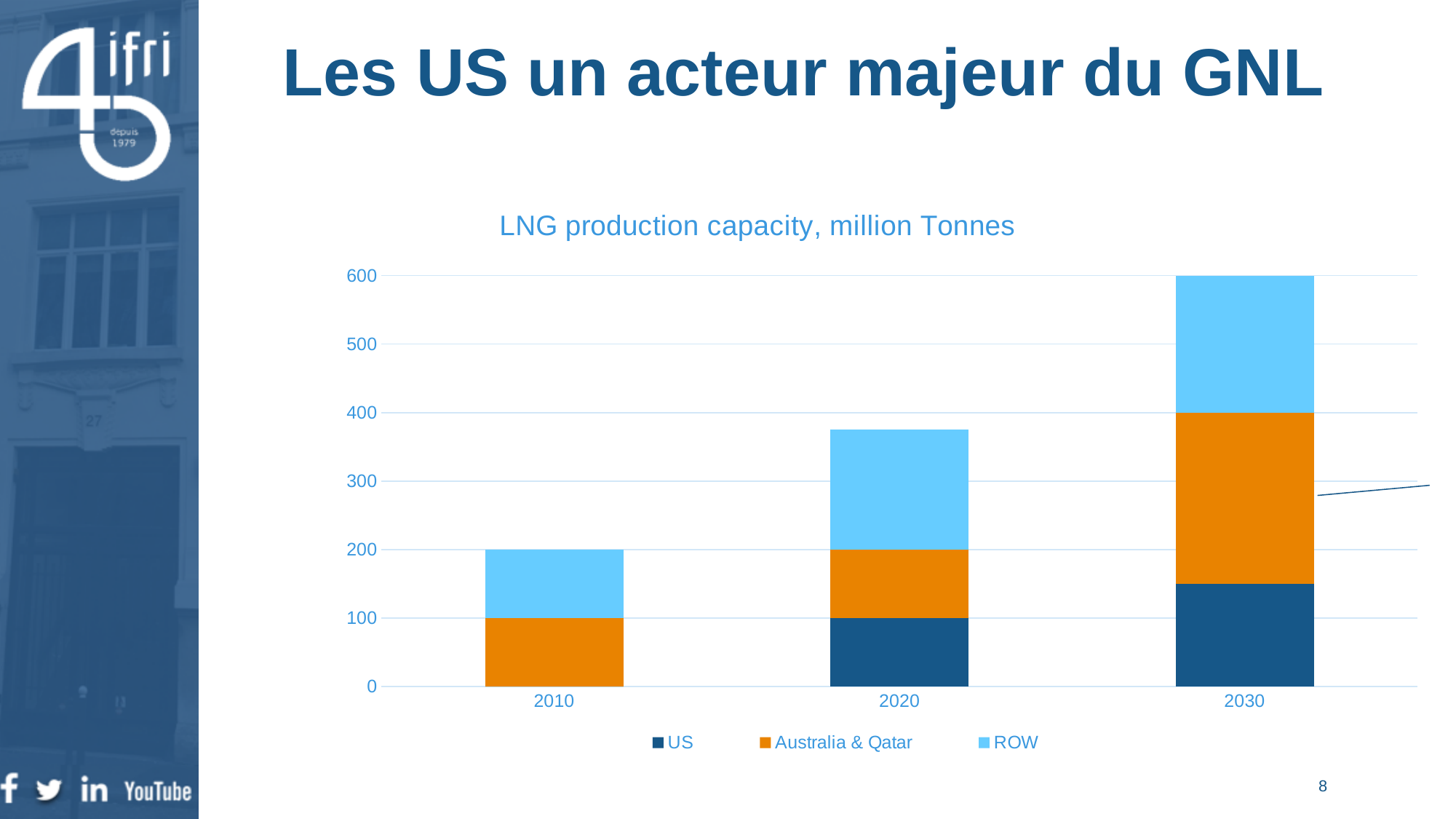
Is the total LNG production capacity for 2020 greater or less than 400? less How many years are shown on the x axis? 3 Which is larger, the ROW segment in 2030 or the ROW segment in 2010? 2030 What kind of chart is shown on the slide? bar chart What is the title of the chart? LNG production capacity, million Tonnes Do the total bar heights rise or fall from 2010 to 2030? rise Is the total LNG production capacity for 2020 greater or less than 300? greater Which year has the highest total LNG production capacity? 2030 What is the total LNG production capacity in 2030? 600 How many series does the legend list? 3 Which year has the lowest total LNG production capacity? 2010 What is the US LNG production capacity in 2020? 100